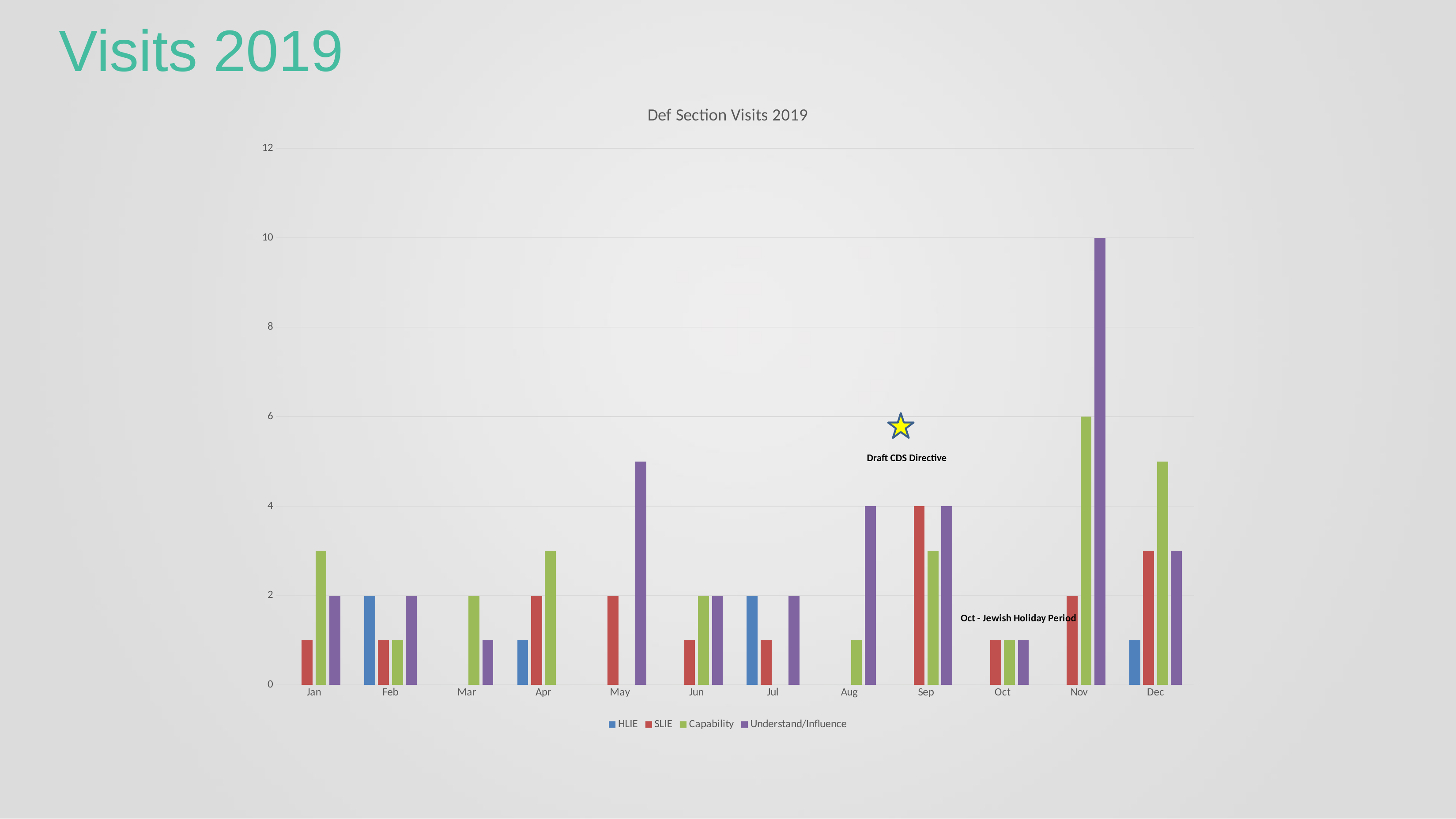
Is the Understand/Influence value for May greater or less than 4? greater What kind of chart is shown on the slide? Bar chart What is the difference between the Understand/Influence value and the Capability value in Nov? 4 In which month is the Understand/Influence value highest? Nov Which is larger, the Capability value for Nov or the Capability value for Dec? Nov How many months are shown on the x axis of the chart? 12 How many series does the legend of the Def Section Visits 2019 chart list? 4 What is the title of the chart? Def Section Visits 2019 What is the SLIE value for Sep? 4 What colour represents the Capability series in the legend? Green What is the Understand/Influence value for Nov? 10 What is the Capability value for Nov? 6